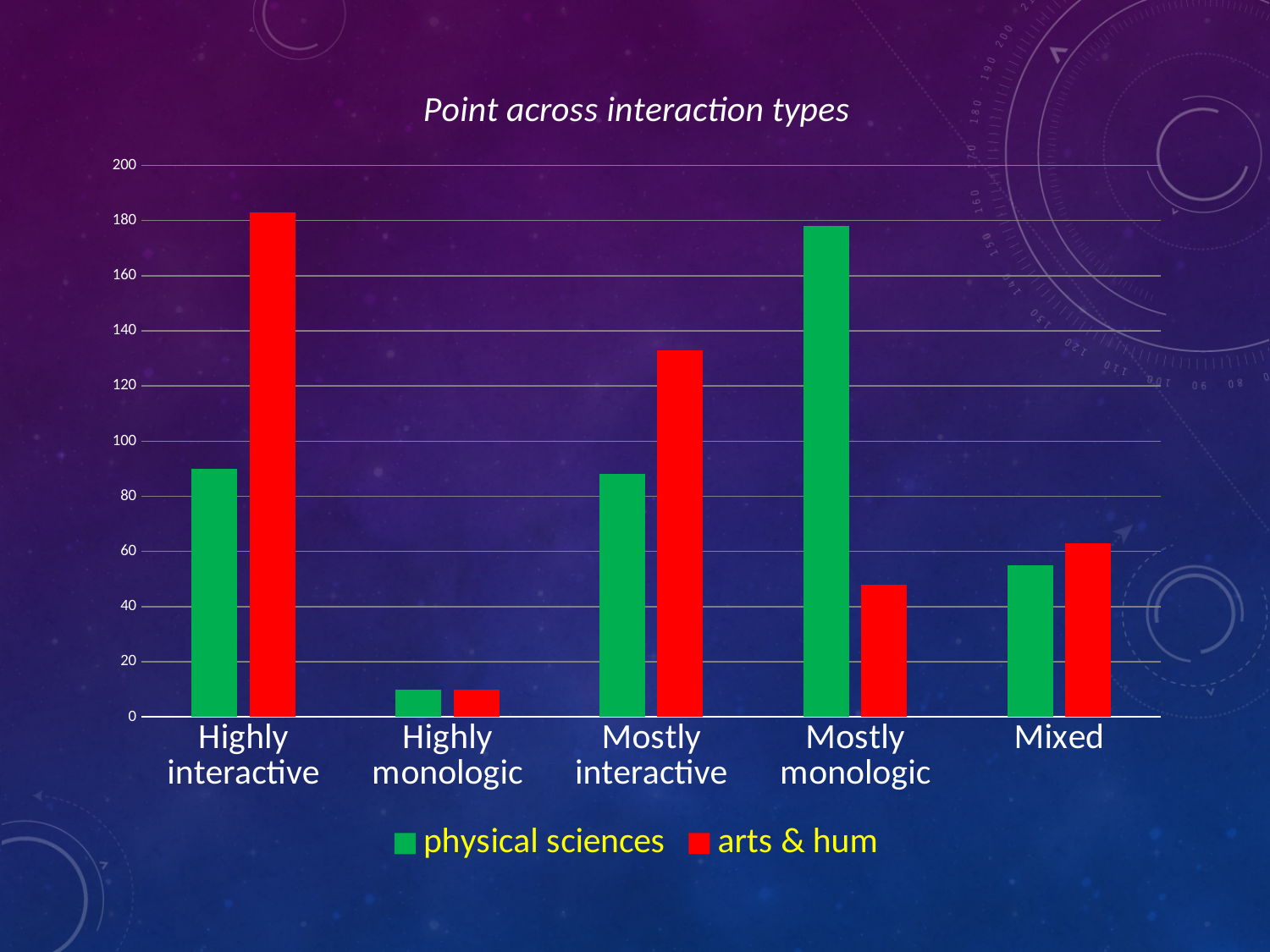
Which colour represents the arts & hum series? red Is the value for physical sciences in Mixed greater or less than 60? less Which category has the lowest value for arts & hum? Highly monologic What kind of chart is shown on the slide? bar chart How many series does the legend list? 2 For Mostly interactive, which series has the larger value, physical sciences or arts & hum? arts & hum How many interaction type categories are shown on the x axis? 5 Which category has the highest value for arts & hum? Highly interactive Is the value for arts & hum in Highly interactive greater or less than 160? greater Which category has the highest value for physical sciences? Mostly monologic What is the title of the chart? Point across interaction types For Mostly monologic, which series has the larger value, physical sciences or arts & hum? physical sciences